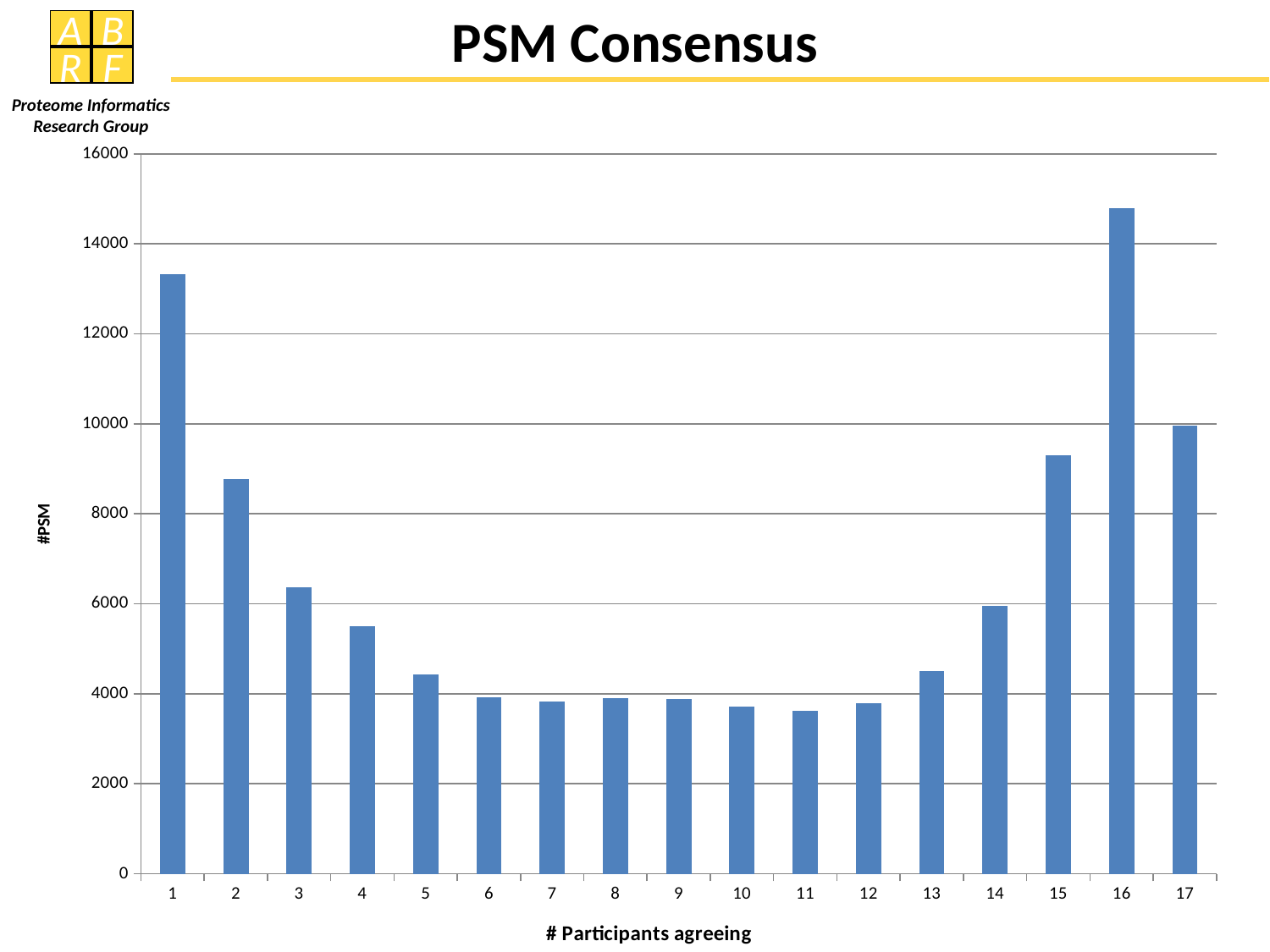
Do the #PSM values rise or fall as the number of participants agreeing goes from 1 to 5? fall How many categories (values of # Participants agreeing) are plotted on the x axis? 17 What kind of chart is shown on the slide? bar chart Which has a higher #PSM: 1 participant agreeing or 17 participants agreeing? 1 Is the #PSM value for 11 participants agreeing greater or less than 4000? less Is the #PSM value for 1 participant agreeing greater or less than 12000? greater Is the #PSM value for 4 participants agreeing greater or less than 6000? less What is the label of the x axis? # Participants agreeing Which number of participants agreeing has the highest #PSM? 16 Which has a higher #PSM: 15 participants agreeing or 17 participants agreeing? 17